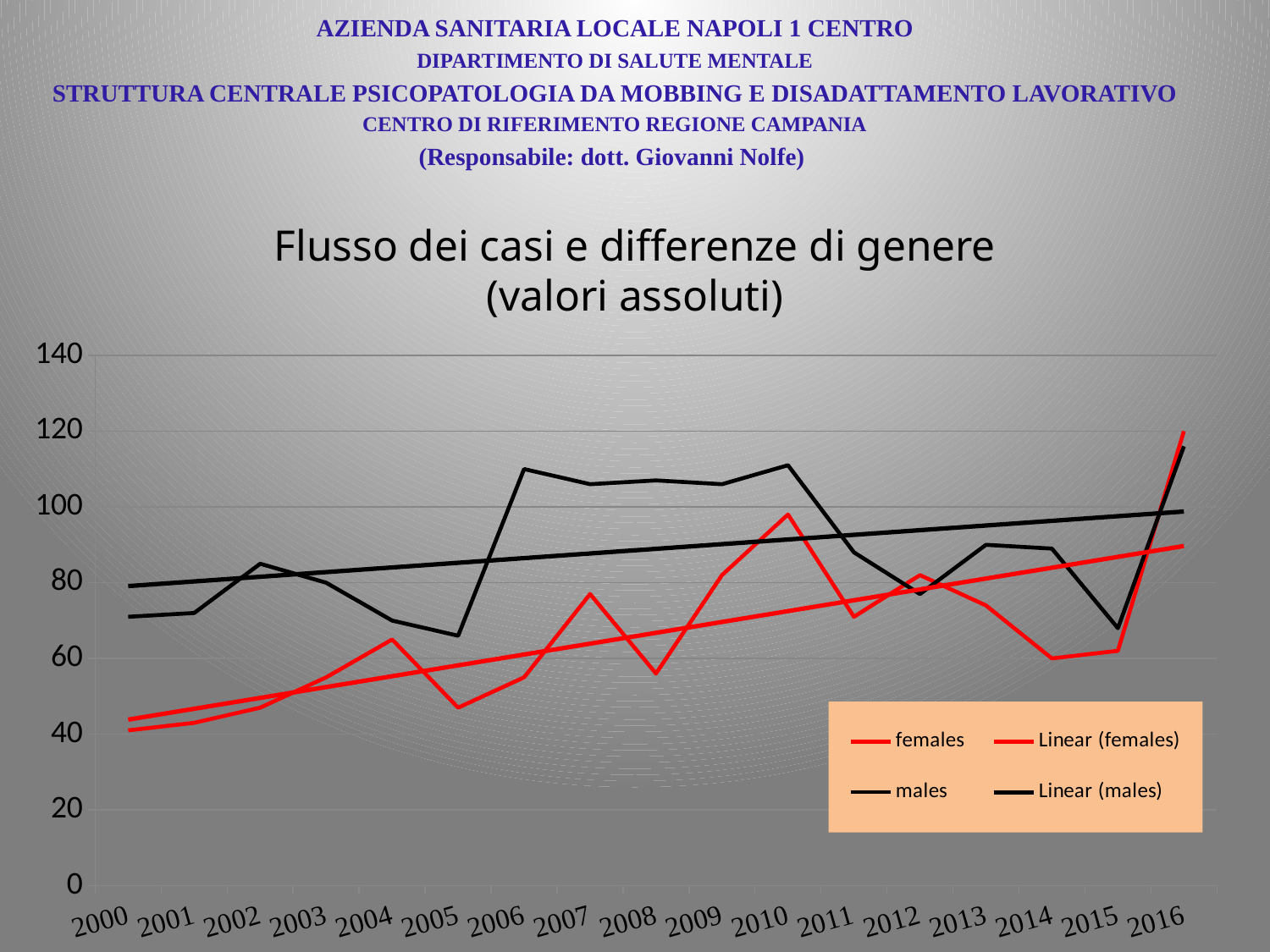
What colour is the line for the females series? red Does the Linear (females) trendline rise or fall from 2000 to 2016? rise In which year does the females series reach its highest value? 2016 Is the value for females in 2016 greater or less than 100? greater How many years are shown on the x axis of the chart? 17 Is the value for females in 2000 greater or less than 60? less In 2010, which series has the larger value, males or females? males Is the value for males in 2005 greater or less than 80? less In 2006, which series has the larger value, males or females? males What kind of chart is shown on the slide? line chart How many entries does the chart legend list? 4